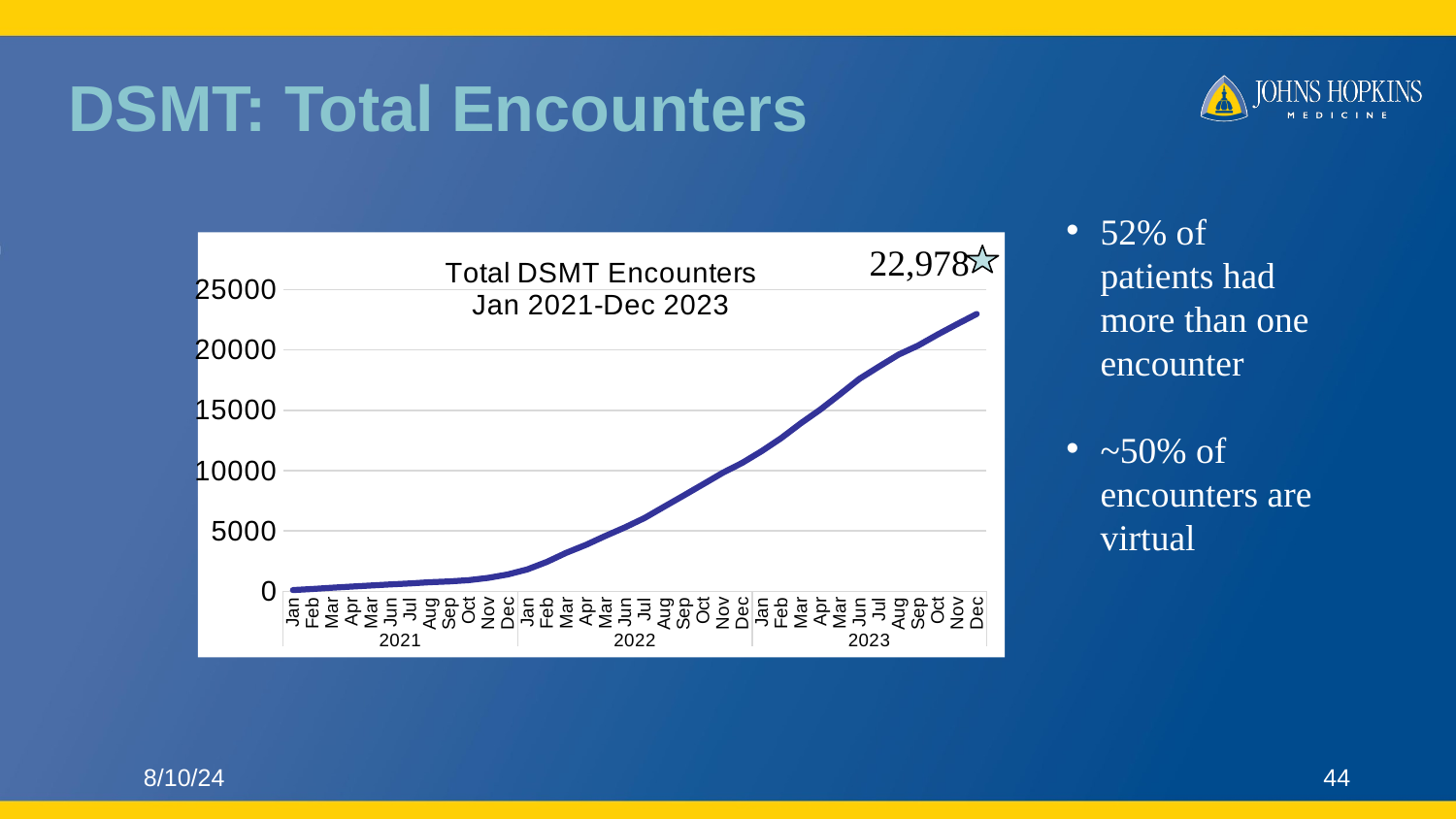
Is the value for Jun 2022 greater or less than 10000? less What value is labelled at the end of the line in Dec 2023? 22,978 Is the value for Dec 2023 greater or less than 20000? greater How many years are labelled along the x axis? 3 Is the value for Jun 2023 greater or less than 15000? greater What kind of chart is shown on the slide? line chart Which month has the highest value on the chart? Dec 2023 Which month has the lowest value on the chart? Jan 2021 Do the values rise or fall from Jan 2021 to Dec 2023? rise Which is larger, the value for Dec 2022 or the value for Dec 2021? Dec 2022 What is the title of the chart? Total DSMT Encounters Jan 2021-Dec 2023